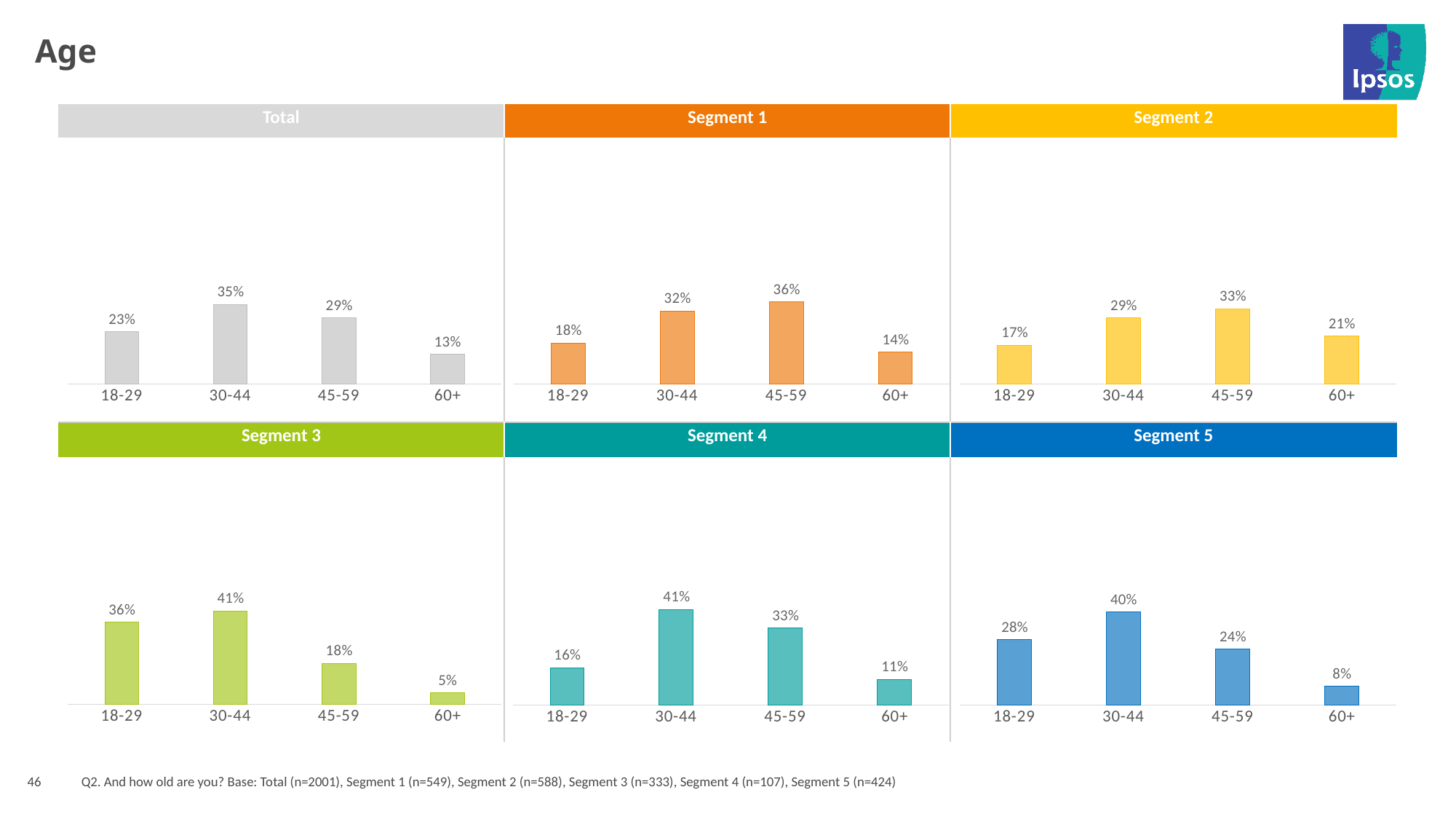
In the Segment 5 chart, what is the difference between the values for 30-44 and 60+? 32% What is the title of the chart in the bottom-left position of the slide? Segment 3 What kind of chart is the Segment 4 chart? Bar chart In the Total chart, what is the value for 30-44? 35% In the Segment 4 chart, what is the difference between the values for 30-44 and 45-59? 8% In the Segment 5 chart, which is larger, the value for 18-29 or the value for 45-59? 18-29 In the Segment 1 chart, which age group has the highest value? 45-59 How many age categories are shown in the Total chart? 4 In the Segment 3 chart, what is the value for 18-29? 36% In the Segment 1 chart, what is the value for 18-29? 18% In the Segment 2 chart, what is the value for 60+? 21% In the Segment 3 chart, which age group has the lowest value? 60+